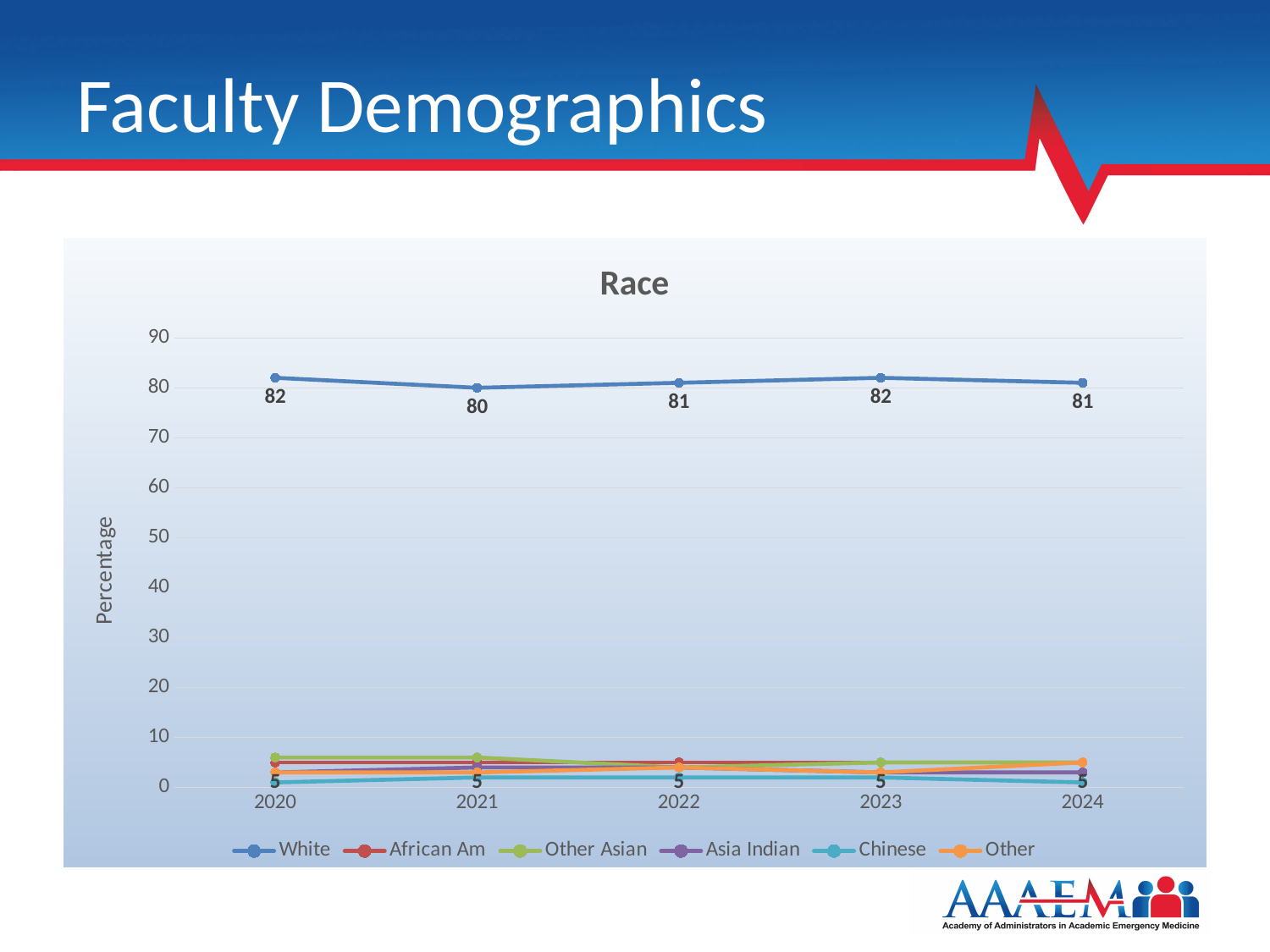
Which is larger, the White value in 2021 or in 2023? 2023 What is the value for White in 2023? 82 What is the value for White in 2020? 82 What is the value for White in 2021? 80 How many years are shown along the x axis of the Race chart? 5 Which series has the higher value in 2024, White or Chinese? White What is the difference between the White values in 2020 and 2021? 2 Is the value for Chinese in 2020 greater or less than 10? less What is the label on the y axis of the chart? Percentage How many series does the legend of the Race chart list? 6 In which year is the value for White lowest? 2021 What kind of chart is shown on the slide? line chart